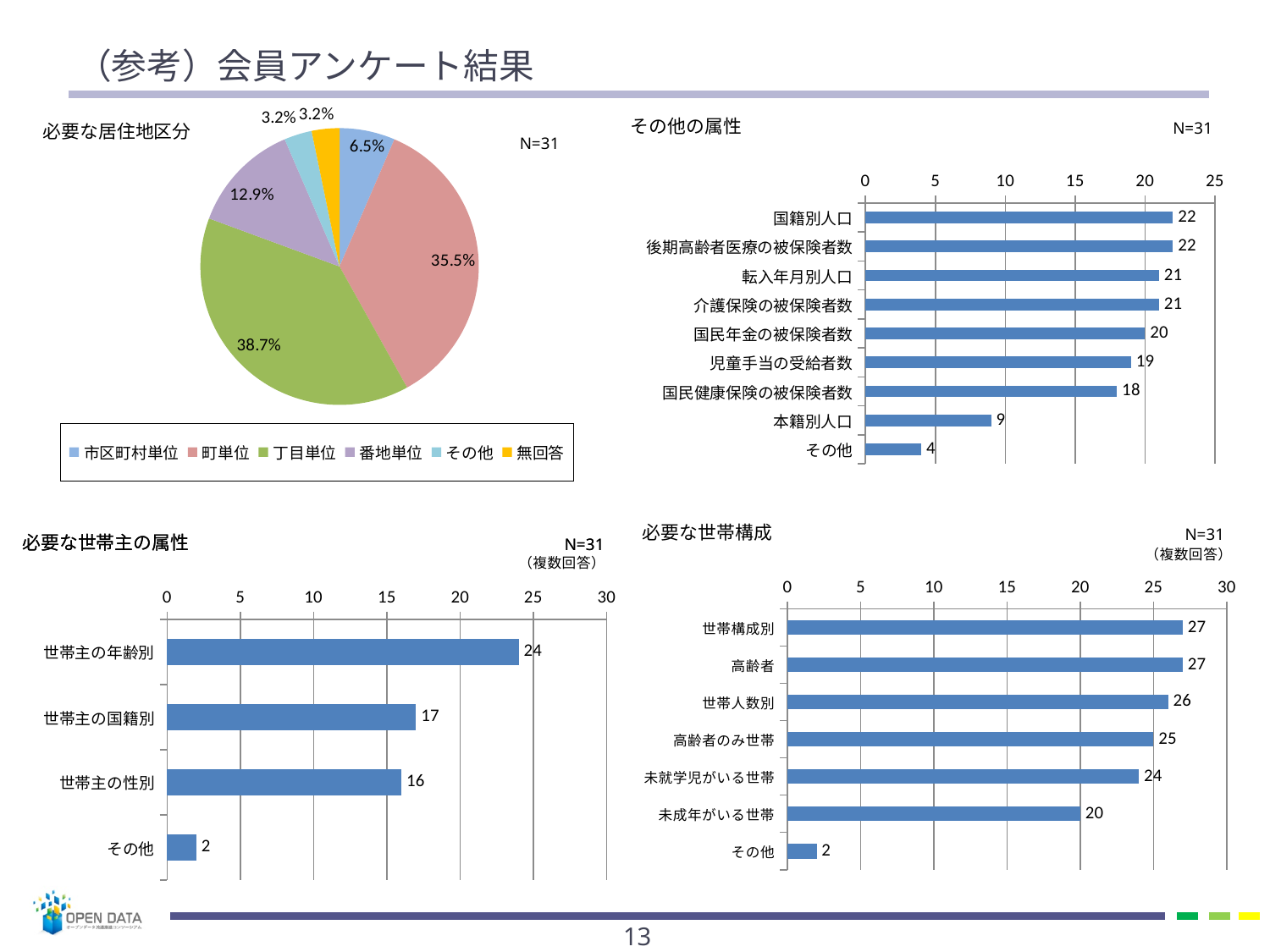
In the chart 必要な世帯主の属性, what is the value for 世帯主の国籍別? 17 In the pie chart 必要な居住地区分, how many categories does the legend list? 6 In the chart 必要な世帯主の属性, which category has the highest value? 世帯主の年齢別 In the chart その他の属性, which category has the lowest value? その他 In the chart 必要な世帯構成, what is the value for 未成年がいる世帯? 20 In the chart 必要な世帯構成, which is larger: 高齢者のみ世帯 or 未就学児がいる世帯? 高齢者のみ世帯 In the chart その他の属性, what is the difference between 国籍別人口 and 国民健康保険の被保険者数? 4 What kind of chart is 必要な世帯構成? bar chart In the chart その他の属性, how many categories are plotted? 9 In the chart その他の属性, what is the value for 本籍別人口? 9 In the pie chart 必要な居住地区分, which category has the largest share? 丁目単位 In the pie chart 必要な居住地区分, what percentage is shown for 丁目単位? 38.7%